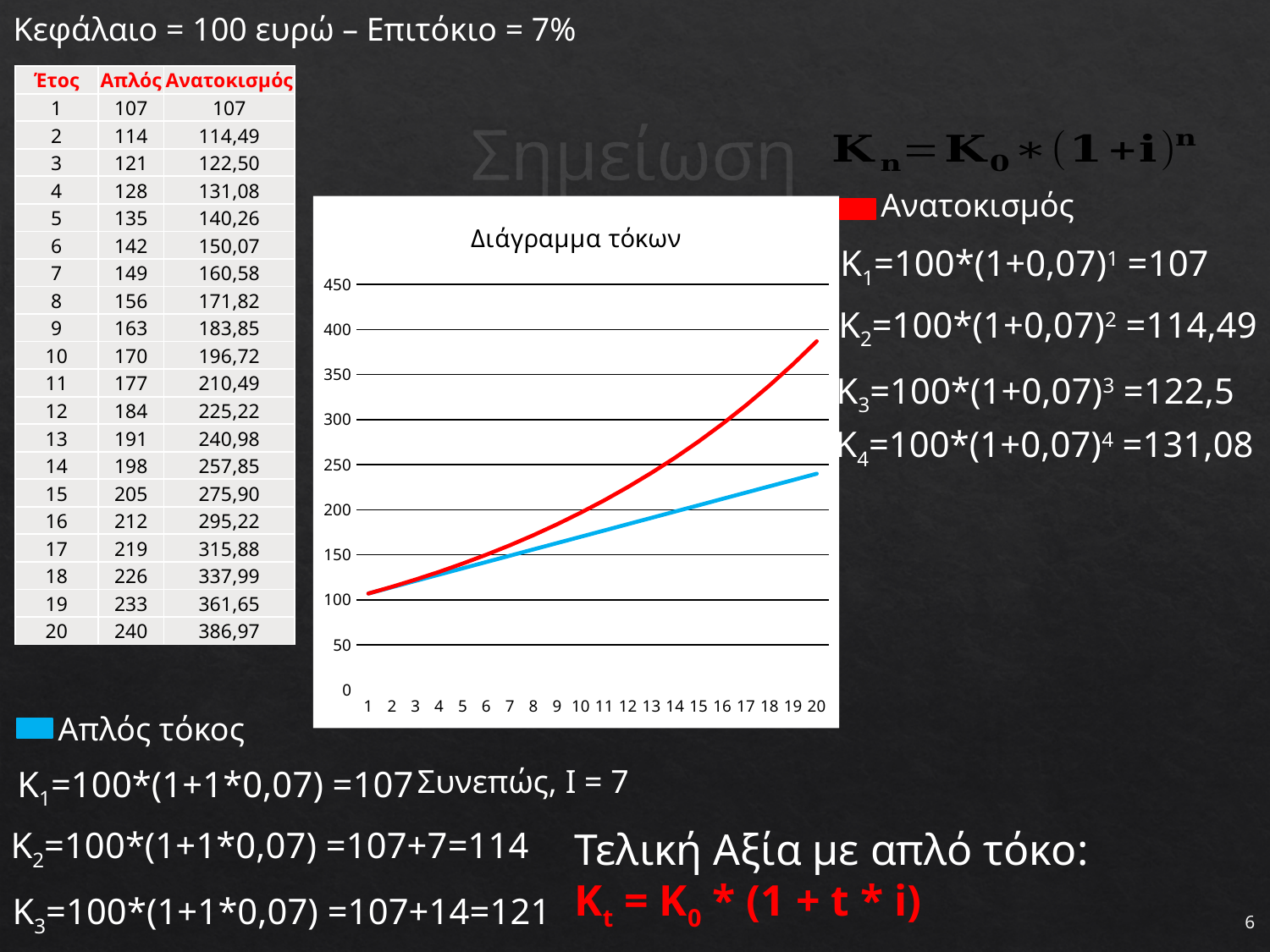
In the 'Διάγραμμα τόκων' chart, which line is higher at year 20, the red (Ανατοκισμός) or the blue (Απλός τόκος)? red (Ανατοκισμός) In the 'Διάγραμμα τόκων' chart, is the value of the red line at year 20 greater or less than 350? greater What is the title of the chart on the slide? Διάγραμμα τόκων In the 'Διάγραμμα τόκων' chart, is the value of the blue line at year 20 greater or less than 250? less What is the highest value shown on the y axis of the 'Διάγραμμα τόκων' chart? 450 In the 'Διάγραμμα τόκων' chart, is the value of the blue line at year 5 greater or less than 150? less Which colour is used for the Ανατοκισμός series in the chart? red What kind of chart is the 'Διάγραμμα τόκων' chart? line chart How many series are plotted in the 'Διάγραμμα τόκων' chart? 2 How many years (points) are shown along the x axis of the 'Διάγραμμα τόκων' chart? 20 In the 'Διάγραμμα τόκων' chart, do the values of the red line rise or fall as the year increases? rise